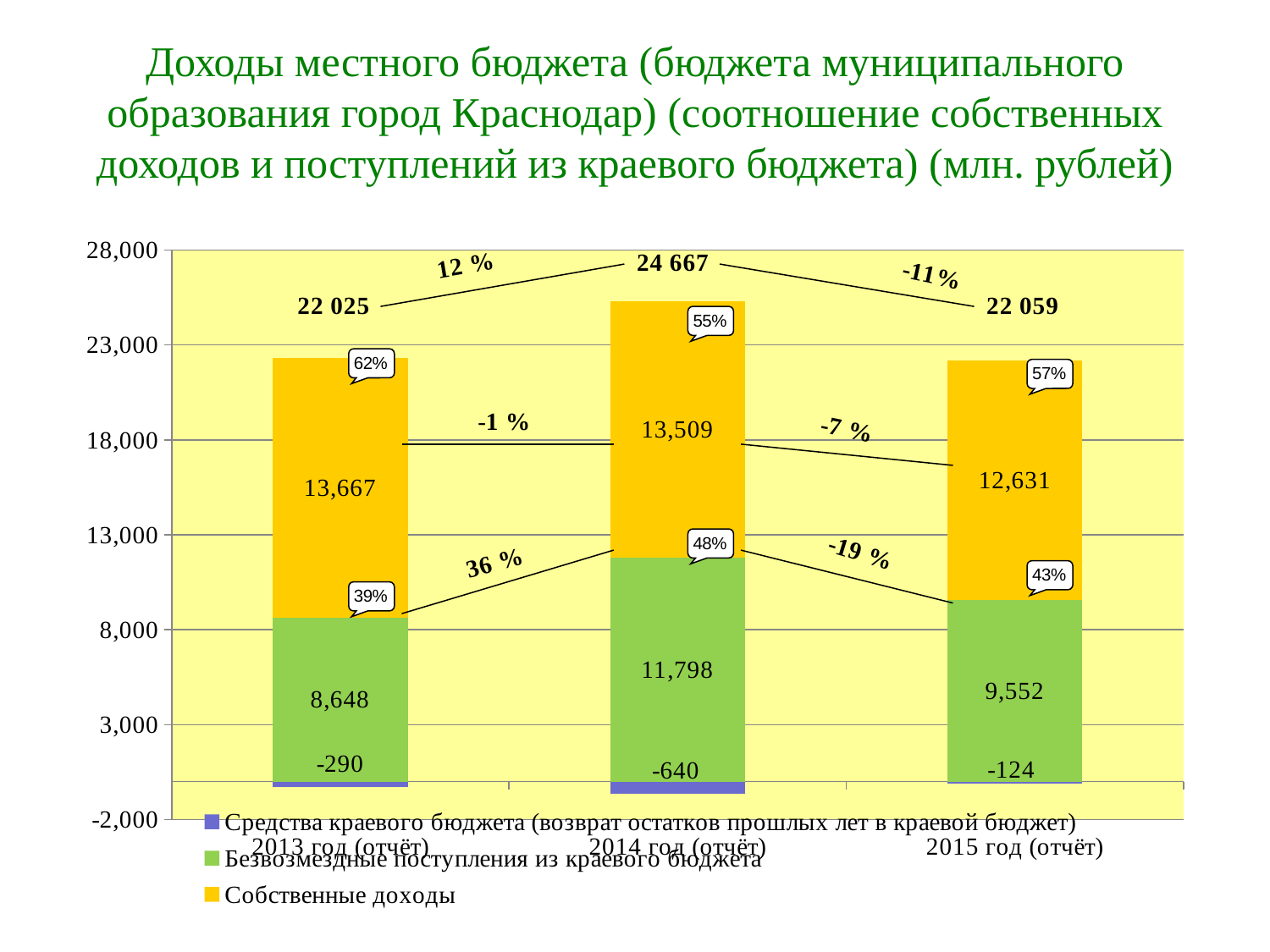
What is the value of Собственные доходы for 2013 год (отчёт)? 13,667 How many years (categories) are shown on the x axis? 3 How many series does the legend list? 3 What total is labelled above the bar for 2014 год (отчёт)? 24 667 Which year has the lowest value of Собственные доходы? 2015 год (отчёт) What is the difference between Собственные доходы in 2013 and in 2015? 1,036 What is the value of Средства краевого бюджета (возврат остатков прошлых лет в краевой бюджет) for 2015 год (отчёт)? -124 Which is larger: Безвозмездные поступления из краевого бюджета in 2013 or in 2015? 2015 год (отчёт) What type of chart is shown on the slide? stacked bar chart What percentage change is annotated between the totals of 2014 and 2015? -11% Which year has the highest value of Безвозмездные поступления из краевого бюджета? 2014 год (отчёт) What is the value of Безвозмездные поступления из краевого бюджета for 2014 год (отчёт)? 11,798